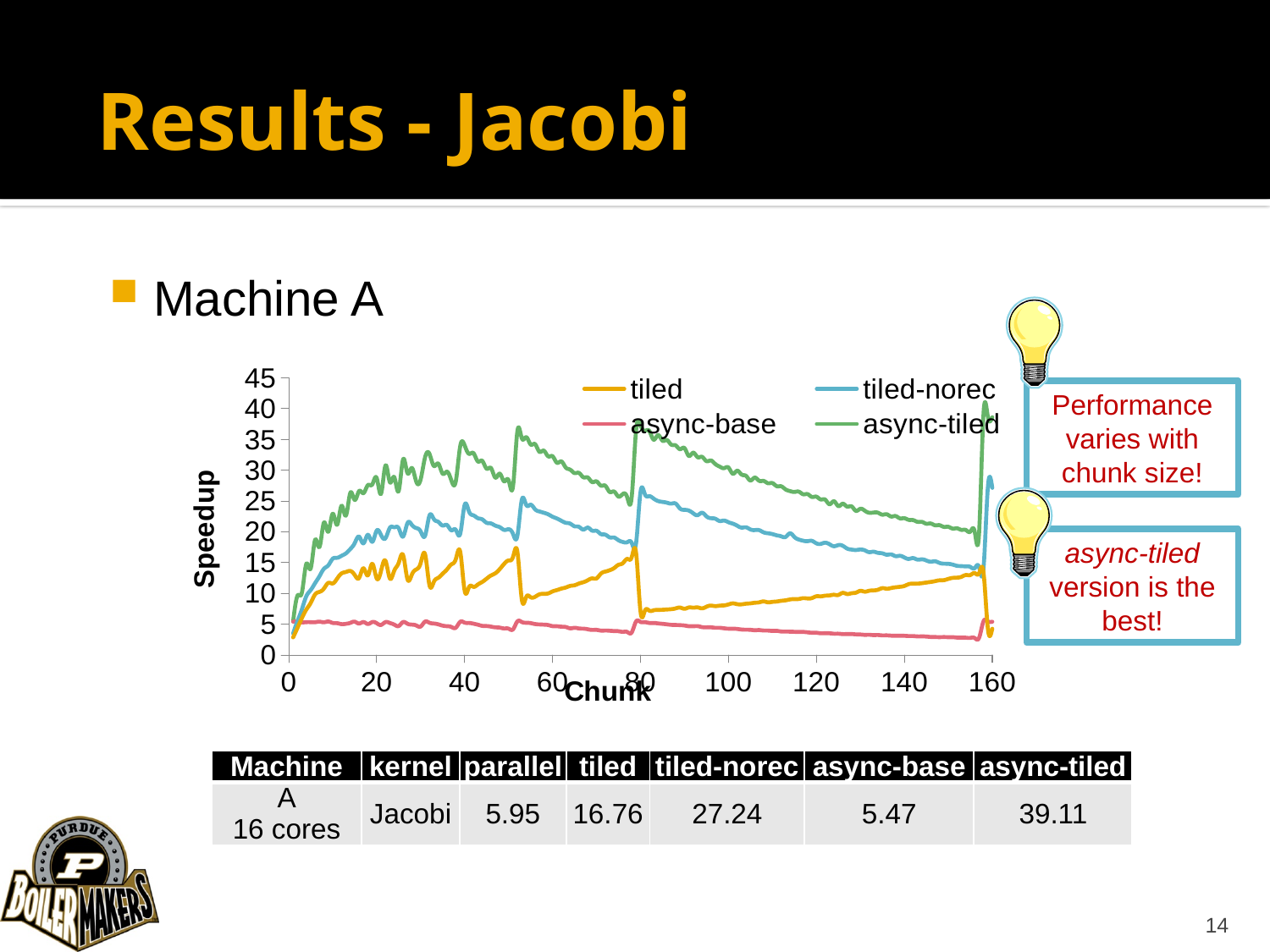
Is the speedup for async-tiled at chunk 100 greater or less than 25? greater Between chunk 80 and chunk 150, does the async-tiled speedup rise or fall? fall Which series reaches the highest speedup on the chart? async-tiled What is the label on the chart's horizontal axis? Chunk What kind of chart is shown on the slide? line chart At chunk 100, which series has the higher speedup, tiled-norec or tiled? tiled-norec Is the speedup for async-base at chunk 80 greater or less than 10? less How many series does the chart's legend list? 4 What is the label on the chart's vertical axis? Speedup Is the speedup for tiled-norec at chunk 60 greater or less than 15? greater Which series has the lowest speedup across the chunk sizes shown? async-base